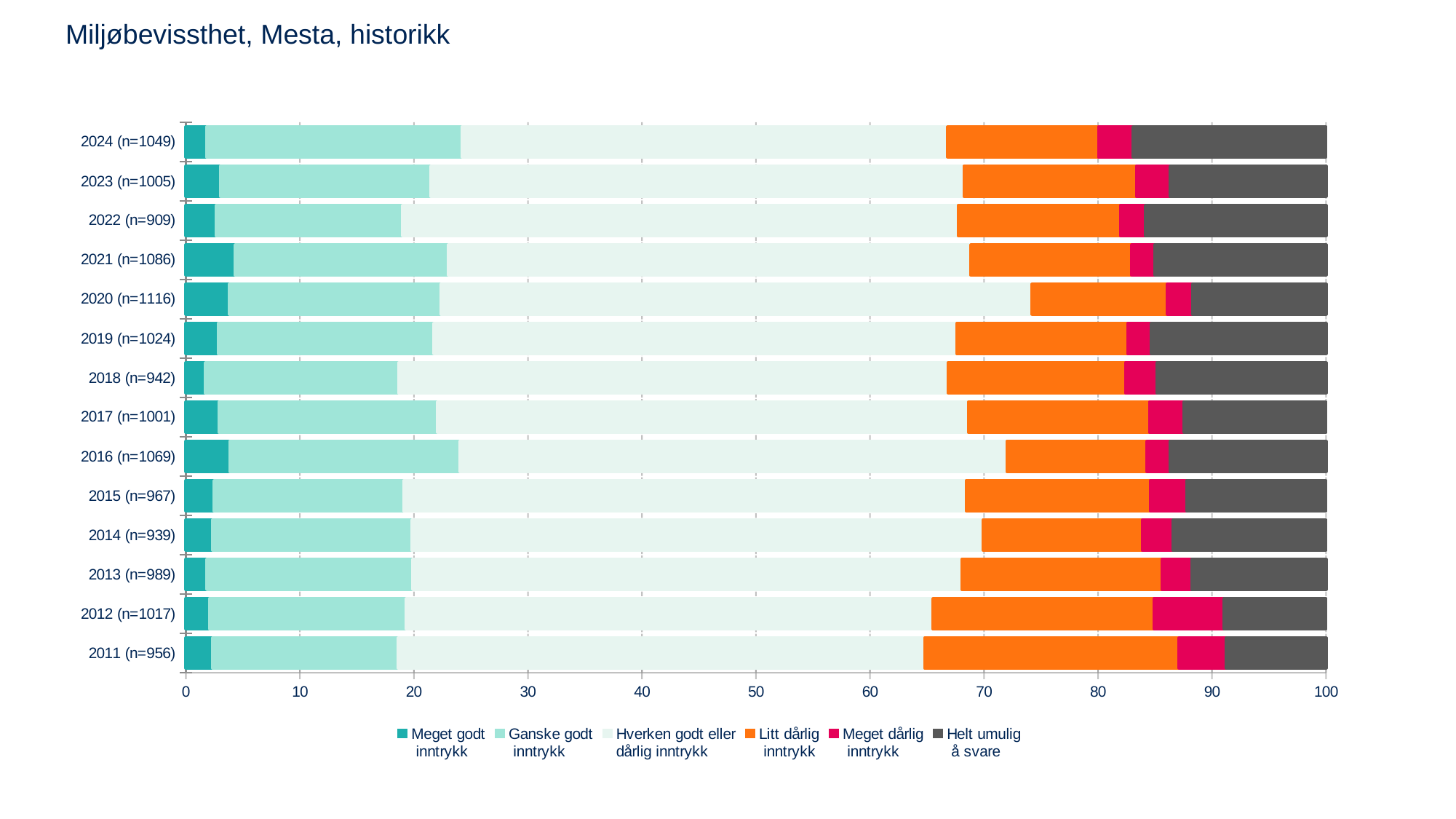
Which legend entry is shown in dark grey? Helt umulig å svare What is the sample size (n) shown for 2011? 956 How many series does the legend list? 6 What is the title of the chart? Miljøbevissthet, Mesta, historikk How many years (categories) are plotted on the chart? 14 What kind of chart is shown on the slide? Stacked bar chart What is the sample size (n) shown for 2024? 1049 Is the point where the 'Hverken godt eller dårlig inntrykk' segment ends for 2020 greater or less than 70? greater Is the point where the 'Hverken godt eller dårlig inntrykk' segment ends for 2011 greater or less than 70? less What value on the axis does each stacked bar reach in total? 100 Which is larger, the 'Meget dårlig inntrykk' segment for 2012 or for 2024? 2012 Is the combined value of 'Meget godt inntrykk' and 'Ganske godt inntrykk' for 2024 greater or less than 20? greater